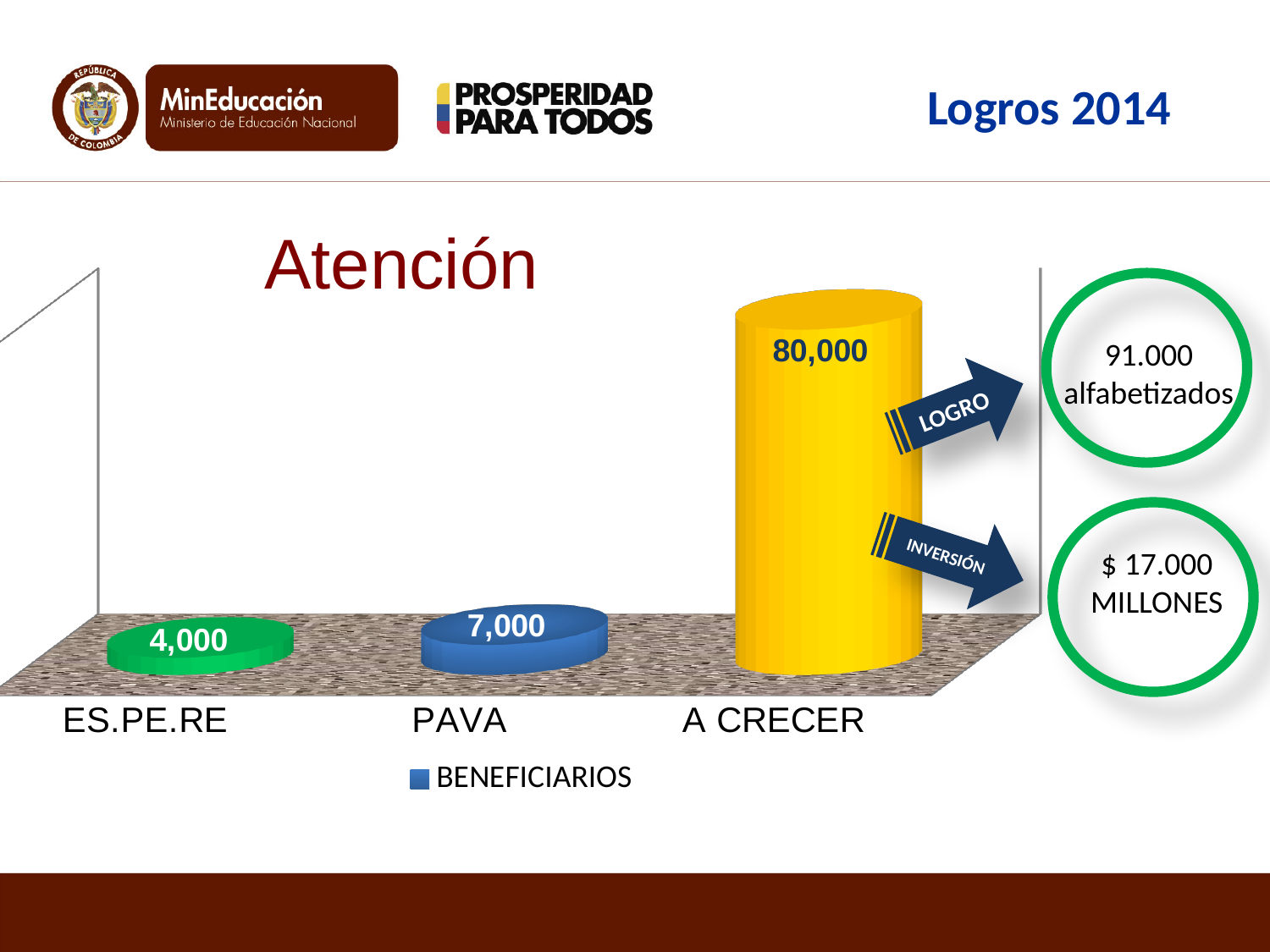
Which is larger, the value for PAVA or the value for ES.PE.RE? PAVA What kind of chart is shown? bar chart What is the difference between the values for PAVA and ES.PE.RE? 3,000 How many series does the legend list? 1 What is the value for ES.PE.RE? 4,000 What is the value for PAVA? 7,000 What is the difference between the values for A CRECER and PAVA? 73,000 What is the name of the series listed in the legend? BENEFICIARIOS Which category has the lowest value? ES.PE.RE Which category has the highest value? A CRECER What is the value for A CRECER? 80,000 How many categories are shown on the chart? 3